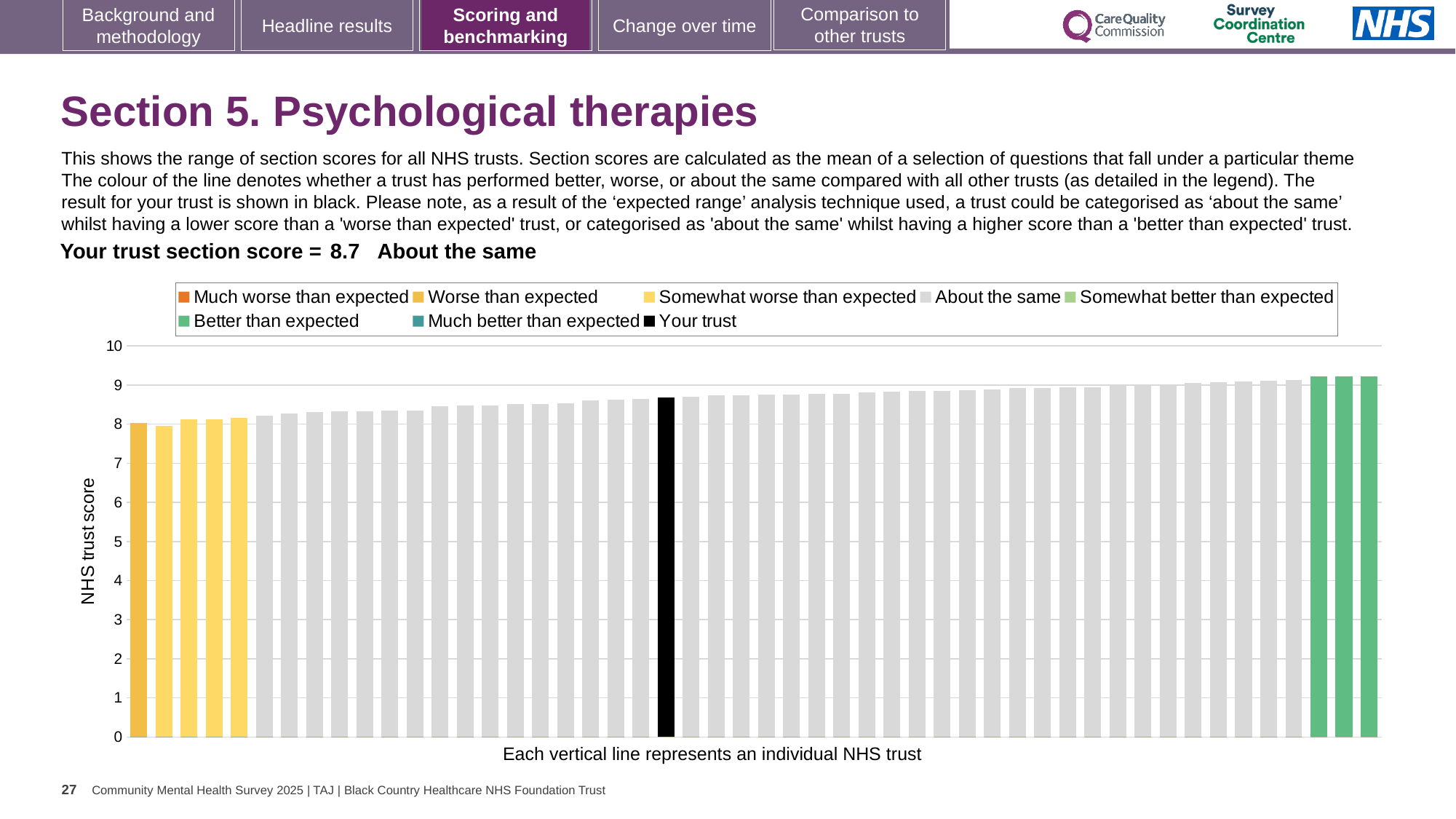
How many entries does the chart legend list? 8 Which is larger: the value of the black bar (your trust) or the value of the leftmost bar? the black bar (your trust) Which category is your trust placed in for this section? About the same Is the value of the black bar (your trust) greater or less than 9? less What is the section score for your trust shown on the slide? 8.7 What colour is the bar representing your trust? black Is the value of the black bar (your trust) greater or less than 8? greater Are the values of the three green bars on the right greater or less than 9? greater What is the label on the vertical axis of the chart? NHS trust score What kind of chart is shown on the slide? bar chart Do the bar values rise or fall from left to right along the x axis? rise